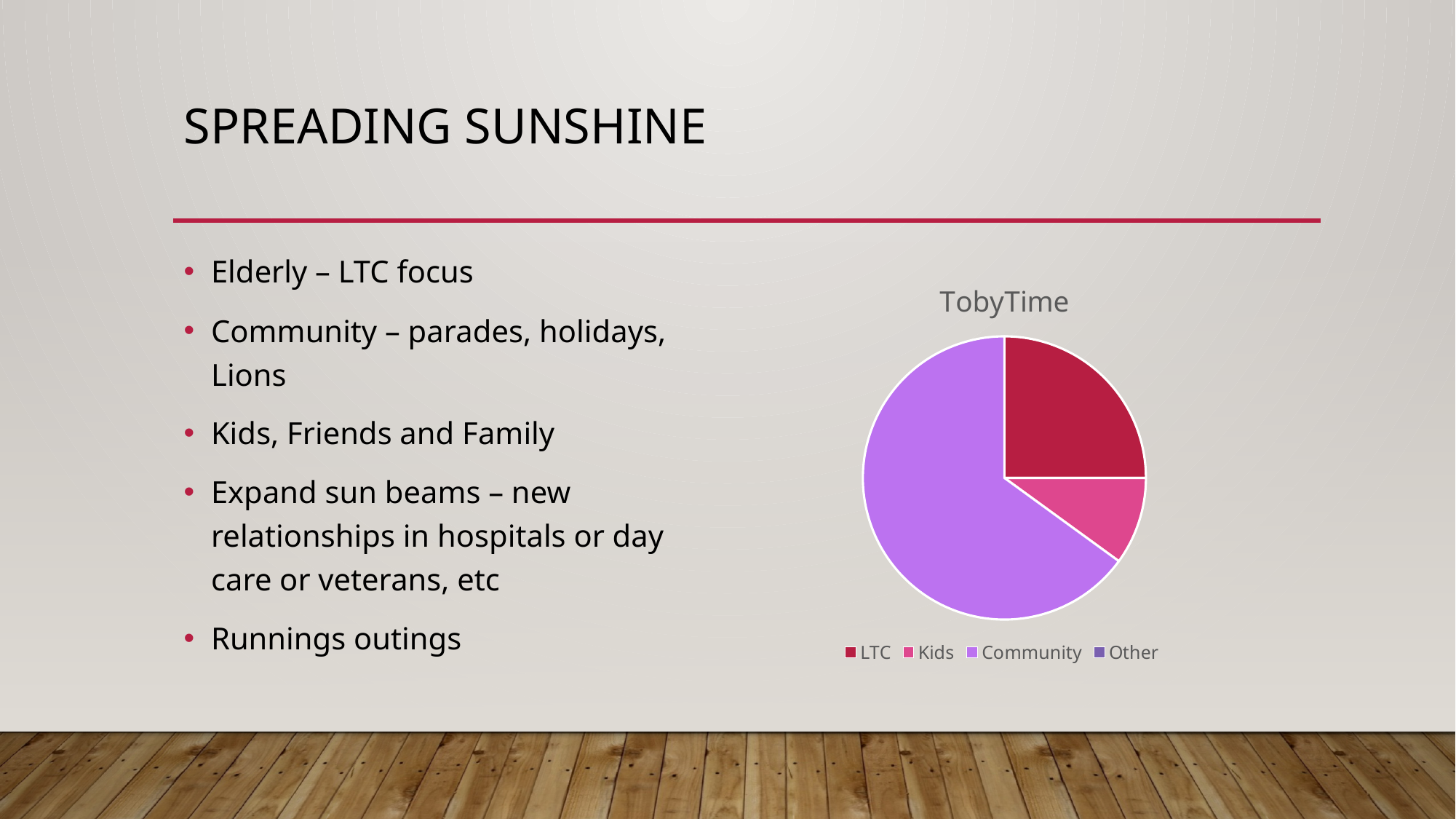
What is the title of the chart? TobyTime Which slice is larger, Kids or Community? Community Does the Community slice take up more or less than half of the pie? more Which slice is larger, Community or LTC? Community How many categories does the chart's legend list? 4 What colour is the Community slice in the pie chart? purple Which category has the largest slice of the pie? Community Does the Kids slice take up more or less than a quarter of the pie? less What kind of chart is shown on the slide? pie chart Which slice is larger, LTC or Kids? LTC